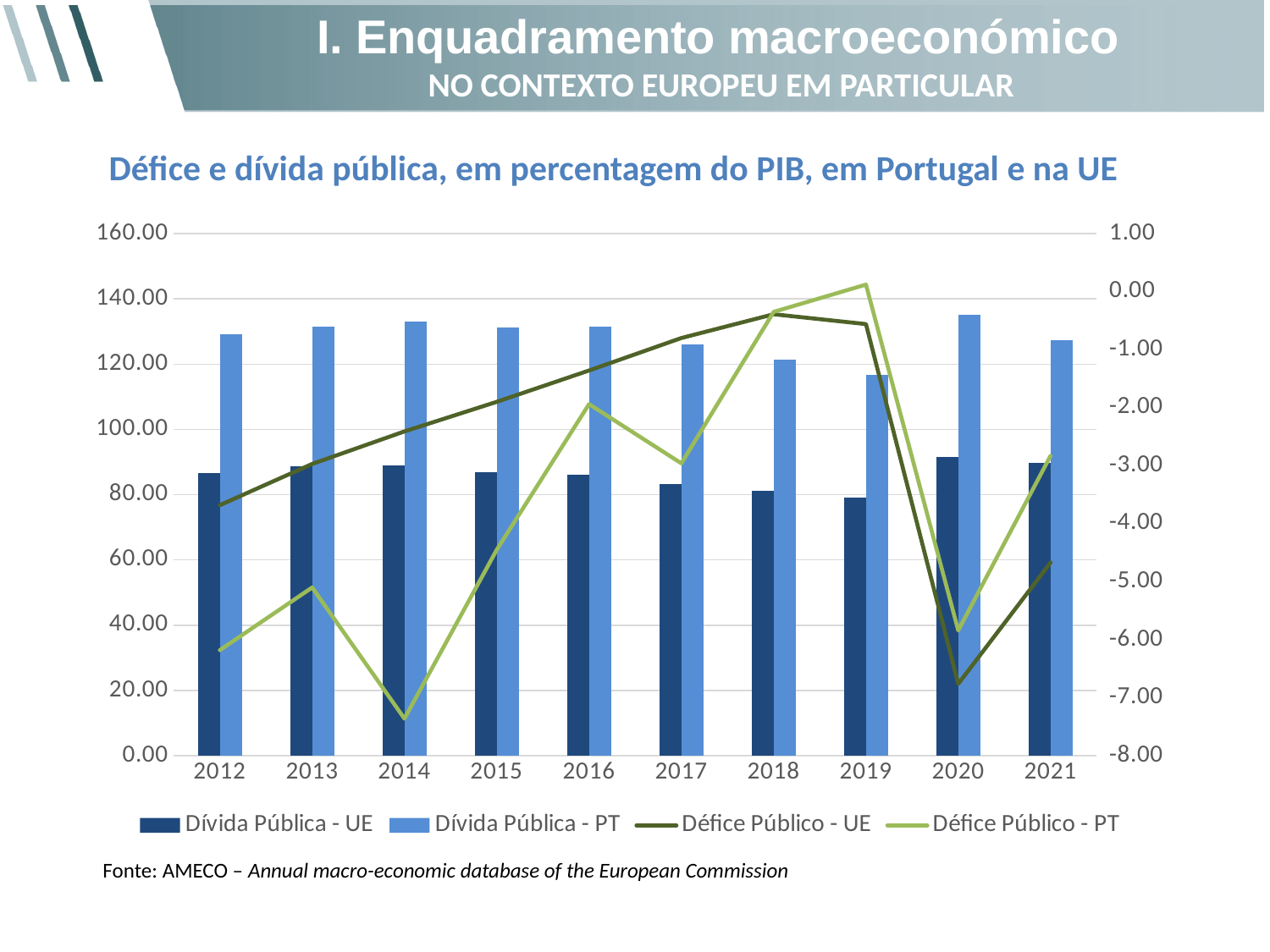
What kind of chart is shown on the slide? A combined bar and line chart Which is larger in 2015, Dívida Pública - PT or Dívida Pública - UE? Dívida Pública - PT Is the value for Défice Público - PT in 2014 greater or less than -7.00? less In which year is Dívida Pública - UE lowest? 2019 Is the value for Dívida Pública - PT in 2012 greater or less than 120.00? greater Does Défice Público - UE rise or fall from 2012 to 2018? rise How many years are shown on the x axis? 10 Is the value for Dívida Pública - UE in 2020 greater or less than 80.00? greater In which year is Défice Público - UE lowest? 2020 How many series does the legend list? 4 In which year is Défice Público - PT lowest? 2014